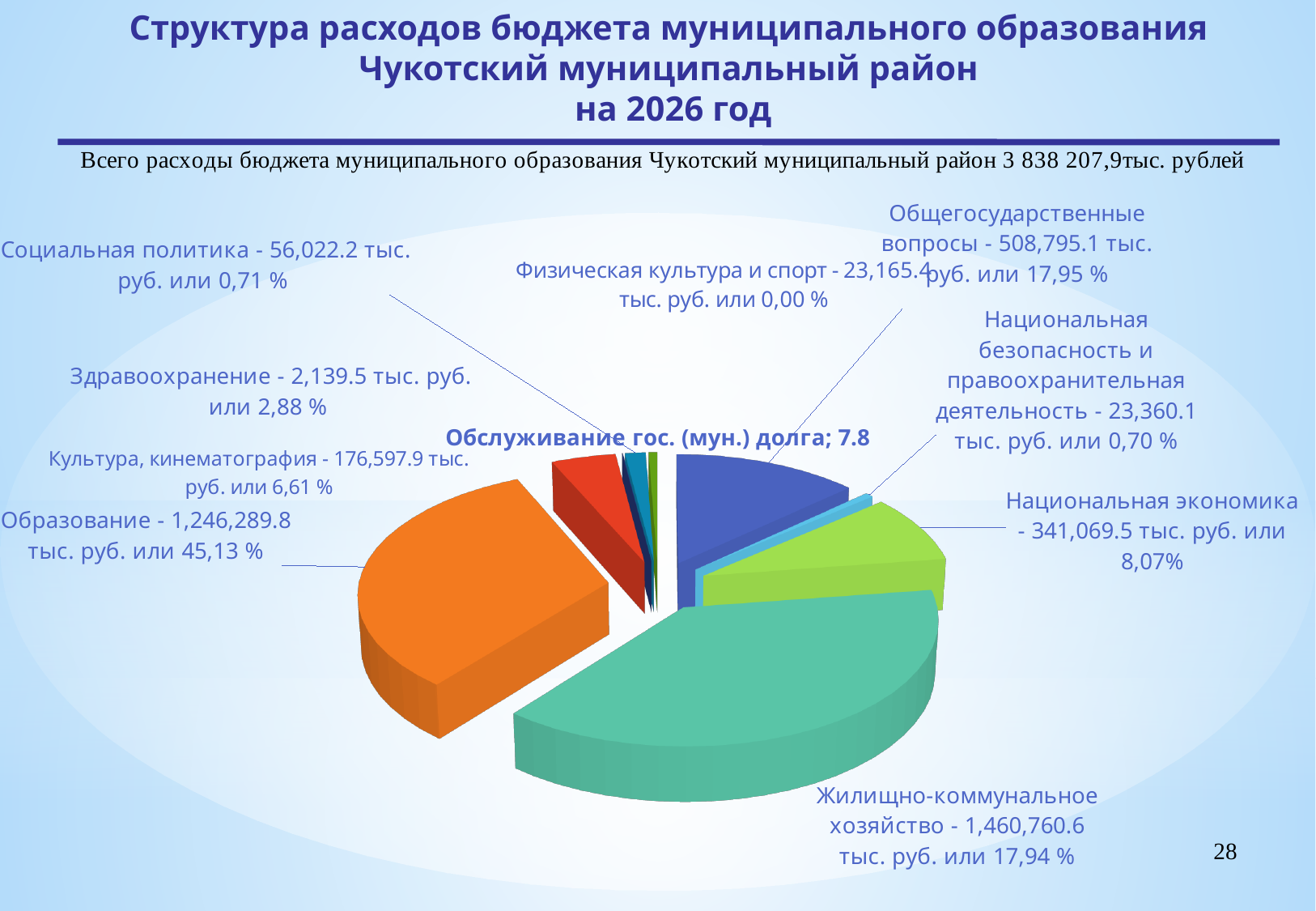
What is the difference in тыс. руб. between Жилищно-коммунальное хозяйство and Образование? 214,470.8 тыс. руб. How many expenditure categories are shown in the pie chart? 10 Which is larger in тыс. руб.: Общегосударственные вопросы or Национальная экономика? Общегосударственные вопросы Which expenditure category has the largest amount in тыс. руб.? Жилищно-коммунальное хозяйство What kind of chart is shown on the slide? Pie chart What is the expenditure for Образование (education) in тыс. руб.? 1,246,289.8 тыс. руб. What is the total budget expenditure of the Chukotsky municipal district for 2026 stated on the slide? 3 838 207,9 тыс. рублей What percentage share is shown for Национальная экономика? 8,07% What value is shown for Обслуживание гос. (мун.) долга? 7.8 What percentage share is shown for Образование? 45,13 % What is the expenditure for Культура, кинематография in тыс. руб.? 176,597.9 тыс. руб. What is the expenditure for Жилищно-коммунальное хозяйство in тыс. руб.? 1,460,760.6 тыс. руб.